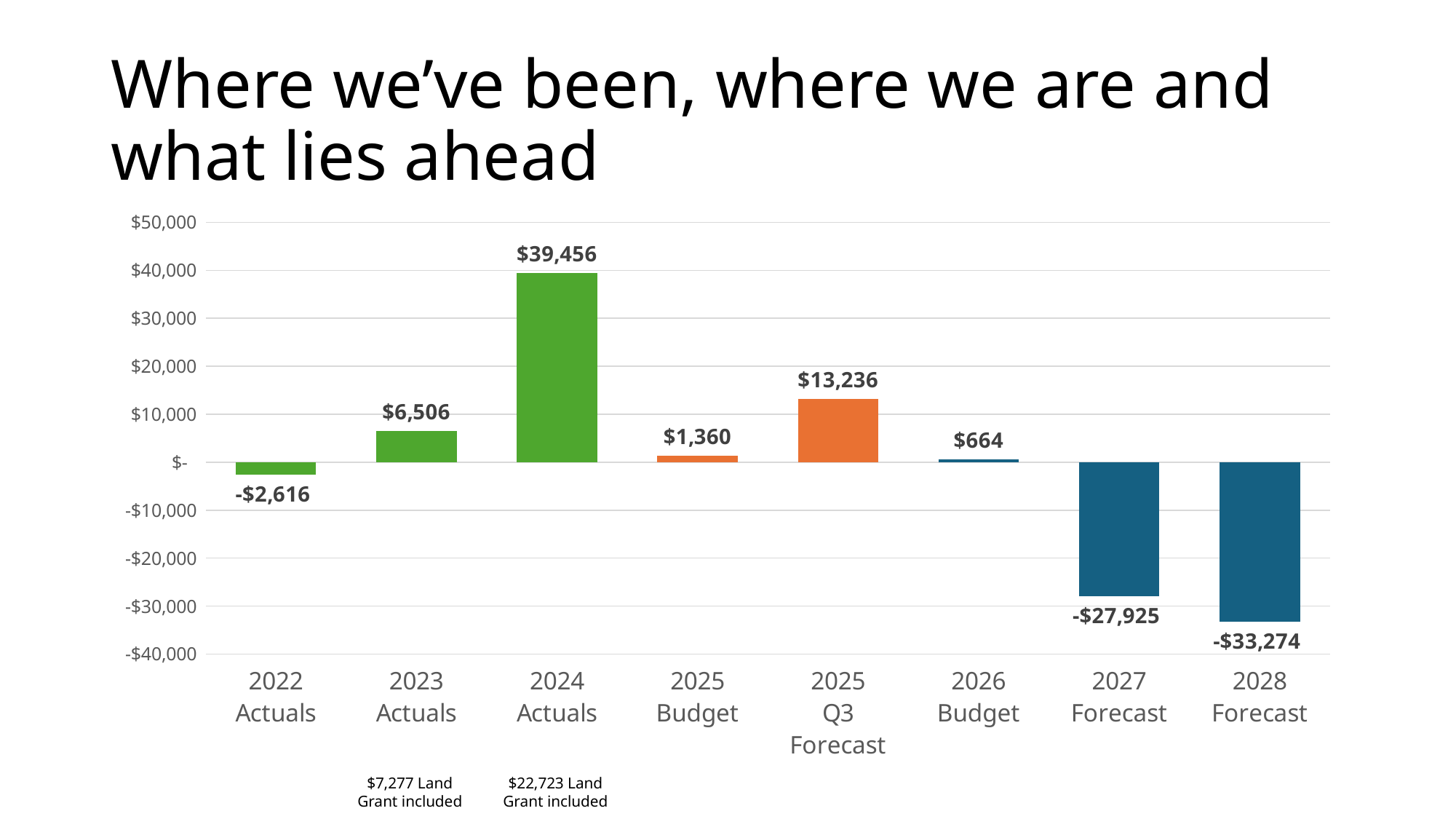
Do the values rise or fall from 2026 Budget to 2028 Forecast? Fall Which is larger, the value for 2025 Budget or the value for 2026 Budget? 2025 Budget What is the value for 2022 Actuals? -$2,616 What is the title of the slide? Where we've been, where we are and what lies ahead What is the difference between 2024 Actuals and 2023 Actuals? $32,950 What is the value for 2024 Actuals? $39,456 What kind of chart is shown on the slide? Bar chart What is the value for 2028 Forecast? -$33,274 Which category has the highest value? 2024 Actuals How many categories are shown on the x axis? 8 What is the value for 2025 Q3 Forecast? $13,236 Which category has the lowest value? 2028 Forecast